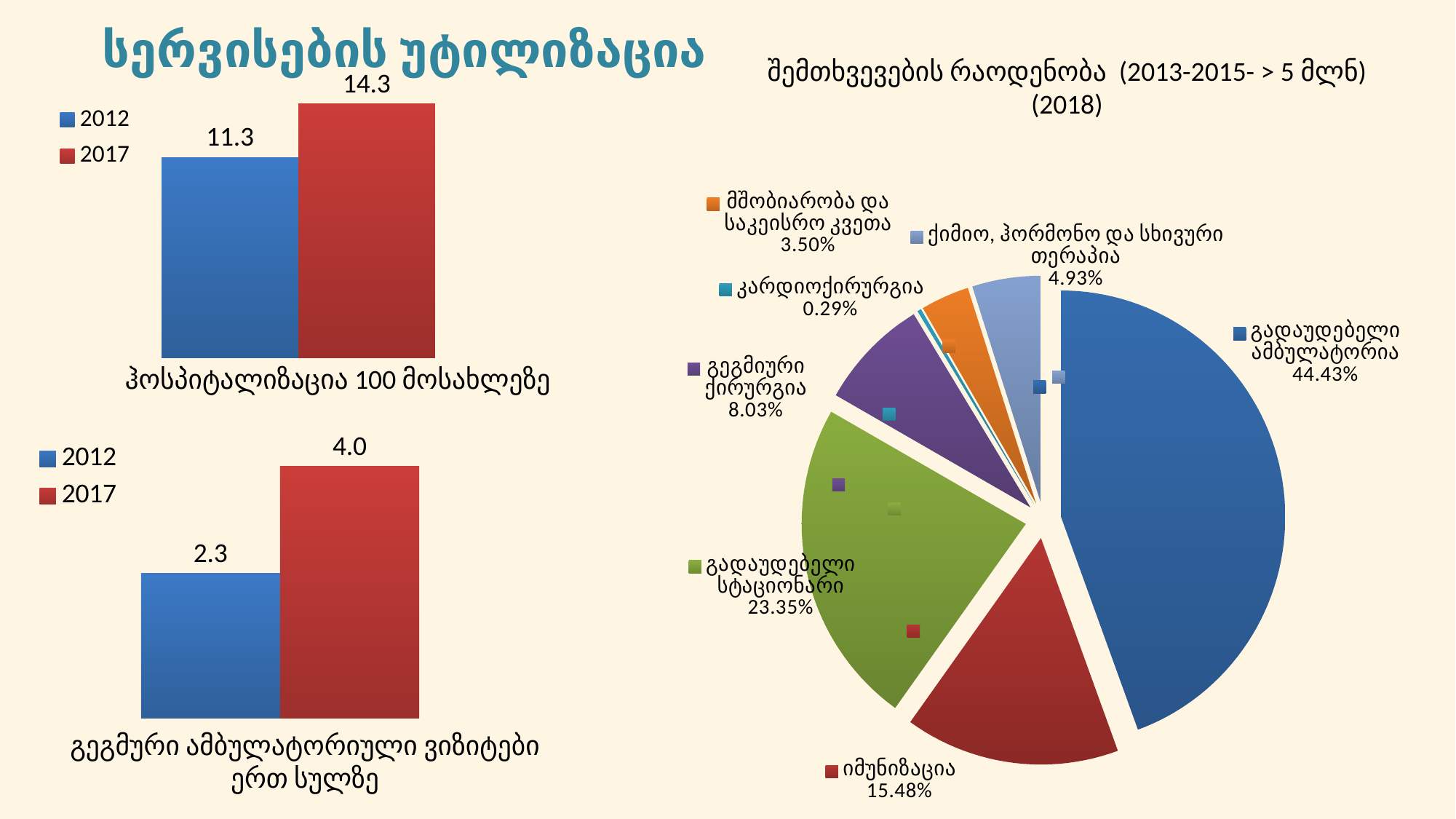
In the bottom-left bar chart (გეგმური ამბულატორიული ვიზიტები ერთ სულზე), what is the value for 2012? 2.3 In the top-left bar chart (ჰოსპიტალიზაცია 100 მოსახლეზე), what is the value for 2017? 14.3 In the bottom-left bar chart (გეგმური ამბულატორიული ვიზიტები ერთ სულზე), which year has the higher value, 2012 or 2017? 2017 In the top-left bar chart (ჰოსპიტალიზაცია 100 მოსახლეზე), what is the value for 2012? 11.3 In the bottom-left bar chart (გეგმური ამბულატორიული ვიზიტები ერთ სულზე), what is the difference between the 2017 and 2012 values? 1.7 In the pie chart on the right, what share does გადაუდებელი ამბულატორია have? 44.43% How many series does the legend of the top-left bar chart list? 2 In the pie chart on the right, which category has the smallest share? კარდიოქირურგია What kind of chart is the chart on the right side of the slide? Pie chart In the pie chart on the right, what is the share for იმუნიზაცია? 15.48% In the top-left bar chart (ჰოსპიტალიზაცია 100 მოსახლეზე), what is the difference between the 2017 and 2012 values? 3.0 How many slices does the pie chart on the right have? 7